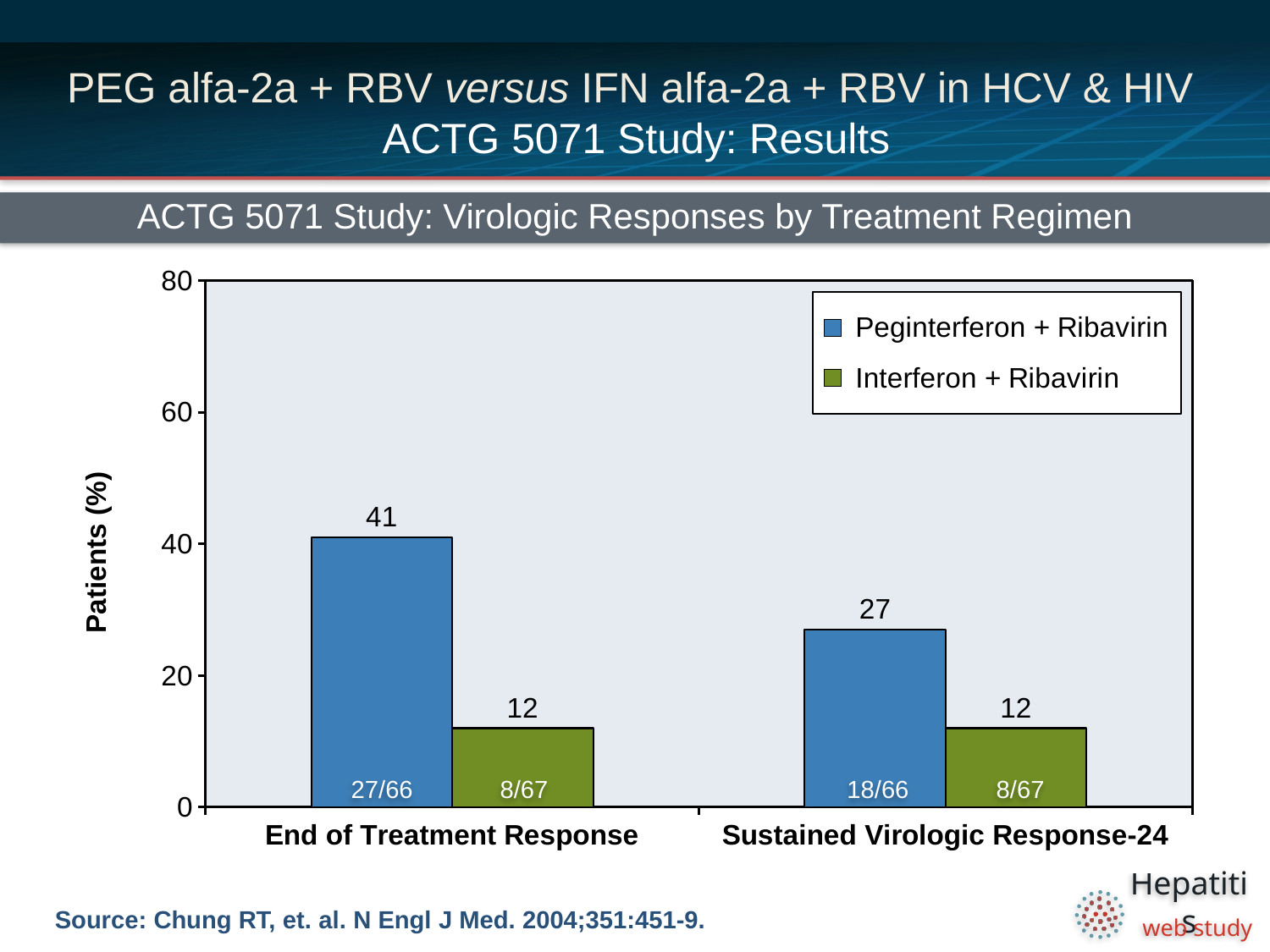
What is the value for Peginterferon + Ribavirin at End of Treatment Response? 41 What fraction of patients is shown inside the Interferon + Ribavirin bar for Sustained Virologic Response-24? 8/67 What fraction of patients is shown inside the Peginterferon + Ribavirin bar for End of Treatment Response? 27/66 Which is larger at Sustained Virologic Response-24: Peginterferon + Ribavirin or Interferon + Ribavirin? Peginterferon + Ribavirin What is the value for Peginterferon + Ribavirin at Sustained Virologic Response-24? 27 What kind of chart is shown on the slide? Bar chart How many categories are shown on the x axis? 2 What is the value for Interferon + Ribavirin at Sustained Virologic Response-24? 12 Which bar has the highest value on the chart? Peginterferon + Ribavirin, End of Treatment Response How many series does the legend list? 2 What is the difference between the Peginterferon + Ribavirin values for End of Treatment Response and Sustained Virologic Response-24? 14 What is the difference between the Peginterferon + Ribavirin and Interferon + Ribavirin values at End of Treatment Response? 29